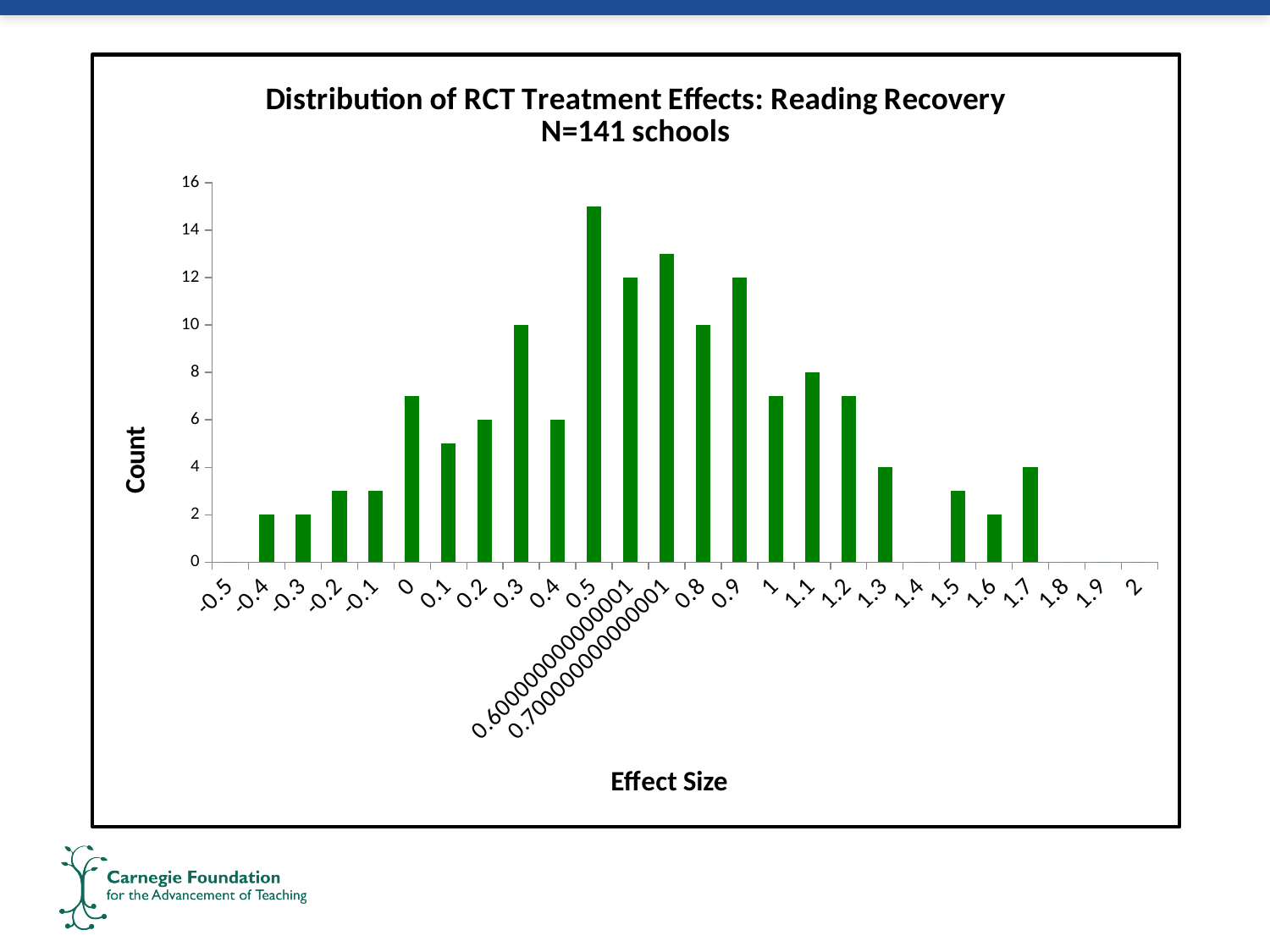
How many bars are plotted in the chart? 21 What is the difference between the counts for effect sizes 0.3 and 0.2? 4 What is the count for effect size 0.9? 12 What is the count for effect size 0.3? 10 What type of chart is shown on the slide? Bar chart Is the count for effect size 1.5 greater or less than 4? less Which has a higher count, effect size 0.5 or effect size 0.9? 0.5 What is the count for effect size 1.1? 8 Which effect size has the highest count? 0.5 What is the label of the y-axis? Count Is the count for effect size 0.5 greater or less than 14? greater What is the title of the chart? Distribution of RCT Treatment Effects: Reading Recovery N=141 schools